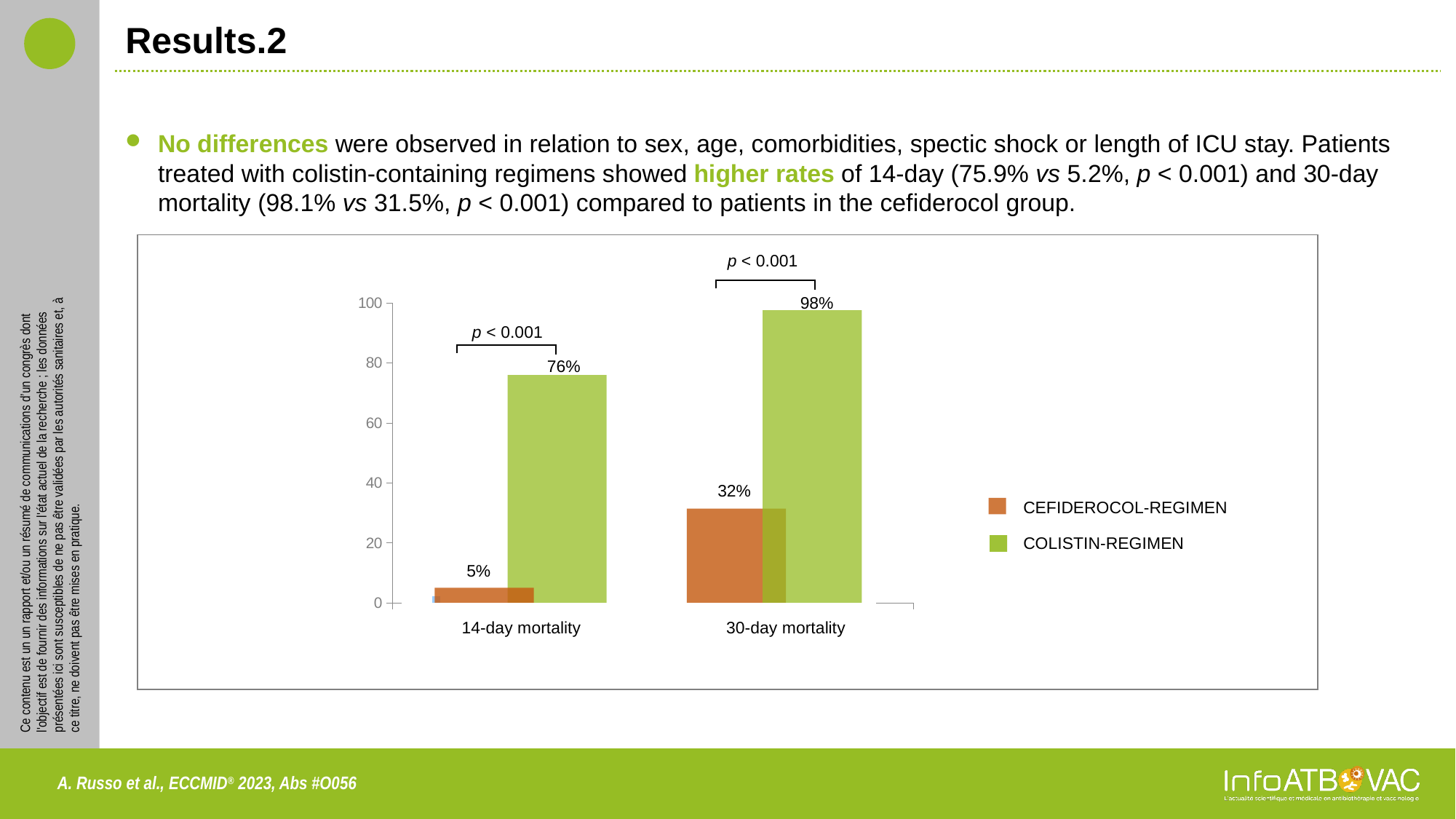
What is the 14-day mortality value for the COLISTIN-REGIMEN series? 76% What is the difference between the COLISTIN-REGIMEN and CEFIDEROCOL-REGIMEN values for 30-day mortality, using the data labels shown? 66% What is the difference between the COLISTIN-REGIMEN and CEFIDEROCOL-REGIMEN values for 14-day mortality, using the data labels shown? 71% Which bar in the chart has the lowest value? CEFIDEROCOL-REGIMEN, 14-day mortality What is the 14-day mortality value for the CEFIDEROCOL-REGIMEN series? 5% What is the 30-day mortality value for the COLISTIN-REGIMEN series? 98% What type of chart is shown on the slide? Bar chart How many series does the legend list? 2 How many categories are shown on the x axis? 2 Which series has the higher 30-day mortality? COLISTIN-REGIMEN What is the 30-day mortality value for the CEFIDEROCOL-REGIMEN series? 32% Which bar in the chart has the highest value? COLISTIN-REGIMEN, 30-day mortality